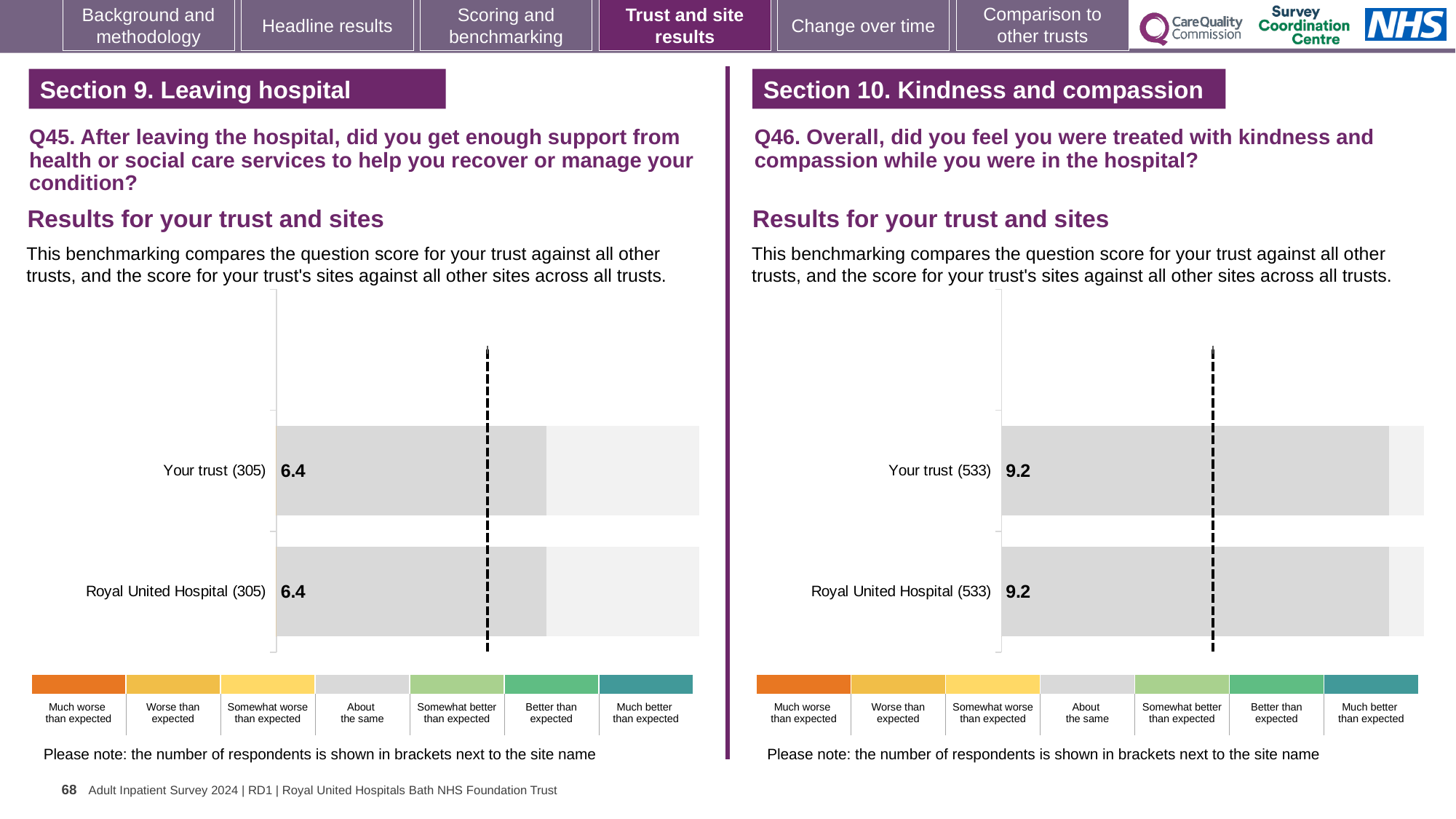
How many respondents are shown in brackets for Royal United Hospital in the Q46 chart on the right? 533 In the Q45 chart on the left, what is the difference between the score for Your trust and the score for Royal United Hospital? 0.0 What kind of chart is used for the Q46 results on the right? Bar chart In the Q46 chart on the right, what is the score for Your trust? 9.2 In the Q46 chart on the right, what is the score for Royal United Hospital? 9.2 How many benchmark categories does the colour legend below the Q45 chart list? 7 How many respondents are shown in brackets for Your trust in the Q45 chart on the left? 305 How many bars are plotted in the Q45 chart on the left? 2 In the legend below the Q46 chart, what colour represents 'Much worse than expected'? Orange In the Q45 chart on the left, what is the score for Royal United Hospital? 6.4 In the Q45 chart on the left, what is the score for Your trust? 6.4 In the Q46 chart on the right, what is the difference between the score for Your trust and the score for Royal United Hospital? 0.0